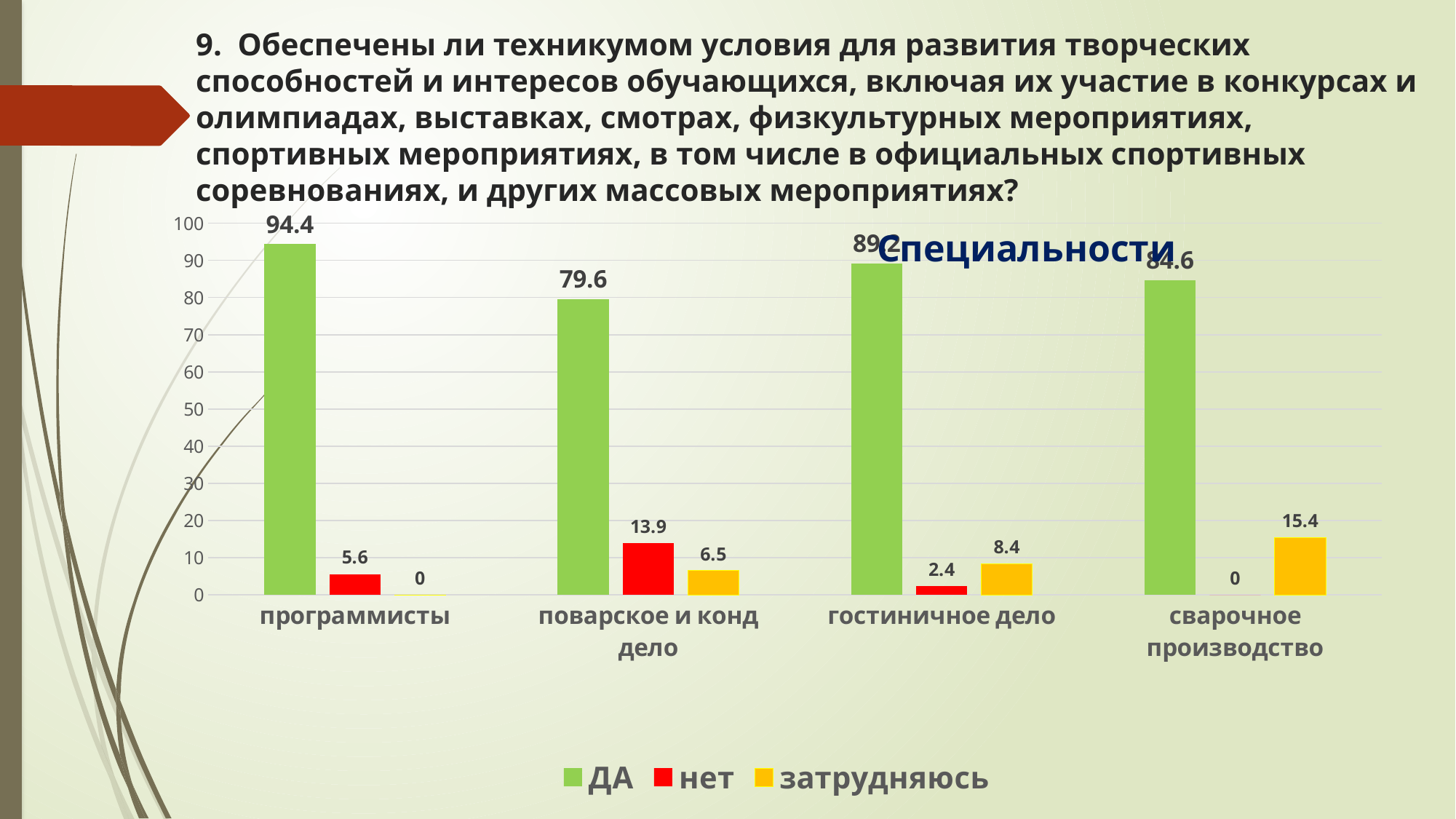
How many series does the legend list? 3 Which is larger: затрудняюсь for гостиничное дело or затрудняюсь for поварское и конд дело? гостиничное дело How many categories are shown on the x axis? 4 Which category has the highest ДА value? программисты Is the ДА value for гостиничное дело greater or less than 80? greater What is the difference between the ДА values for программисты and поварское и конд дело? 14.8 What is the value of ДА for программисты? 94.4 What is the value of нет for поварское и конд дело? 13.9 Which category has the lowest ДА value? поварское и конд дело What is the value of нет for гостиничное дело? 2.4 What is the value of затрудняюсь for сварочное производство? 15.4 What type of chart is shown on the slide? bar chart